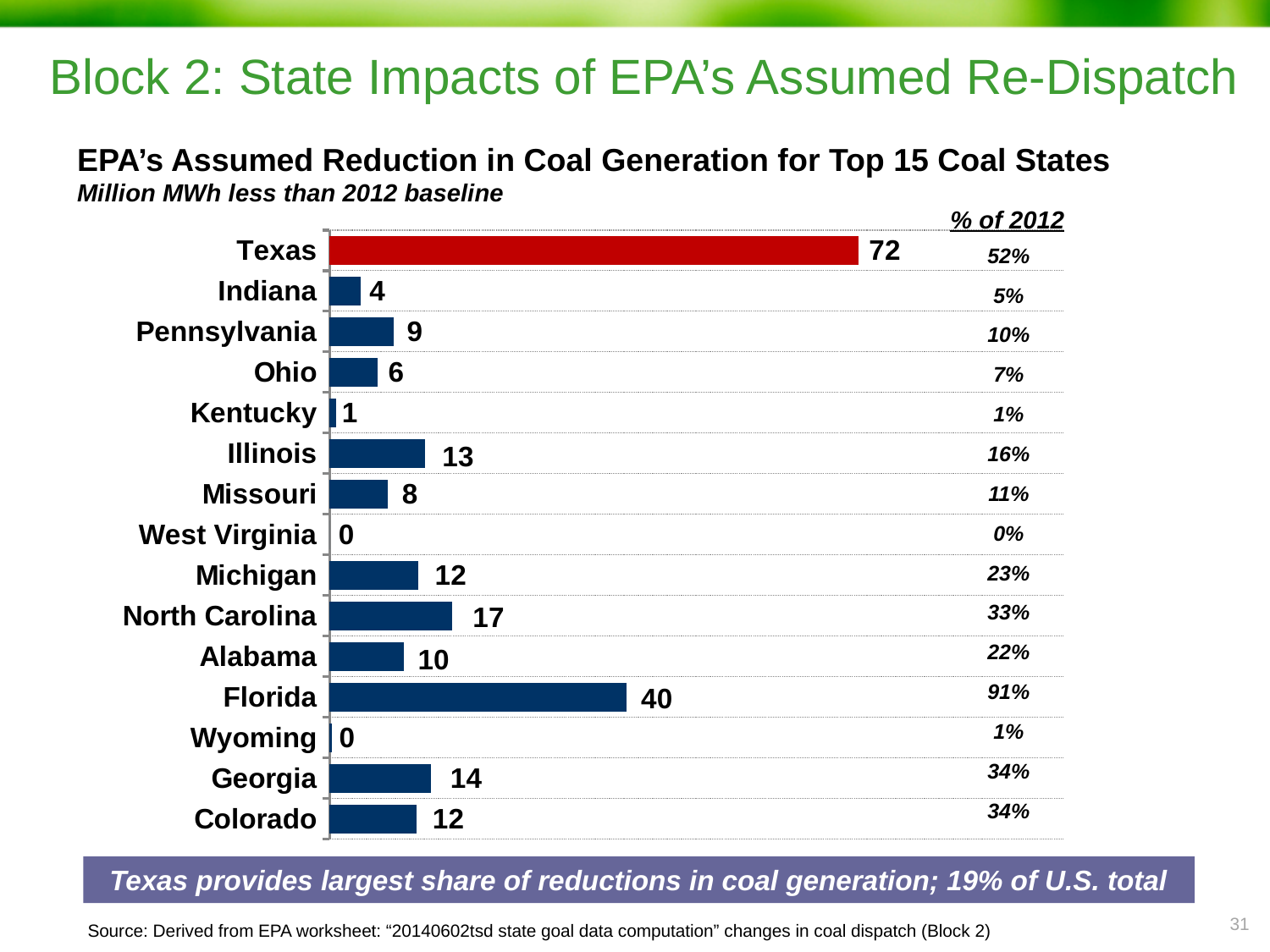
What is the assumed reduction in coal generation for North Carolina, in million MWh? 17 How many states are shown in the chart? 15 What kind of chart is shown on the slide? Bar chart What is the assumed reduction in coal generation for Texas, in million MWh? 72 Which state has the largest assumed reduction in coal generation? Texas What is the difference between the reductions for Texas and Florida, in million MWh? 32 What is the '% of 2012' value shown for Texas? 52% Which state has the larger assumed reduction, Illinois or Michigan? Illinois What is the '% of 2012' value shown for Florida? 91% Which state's bar is coloured red rather than blue? Texas What is the difference between the reductions for Georgia and Colorado, in million MWh? 2 What is the assumed reduction in coal generation for Florida, in million MWh? 40